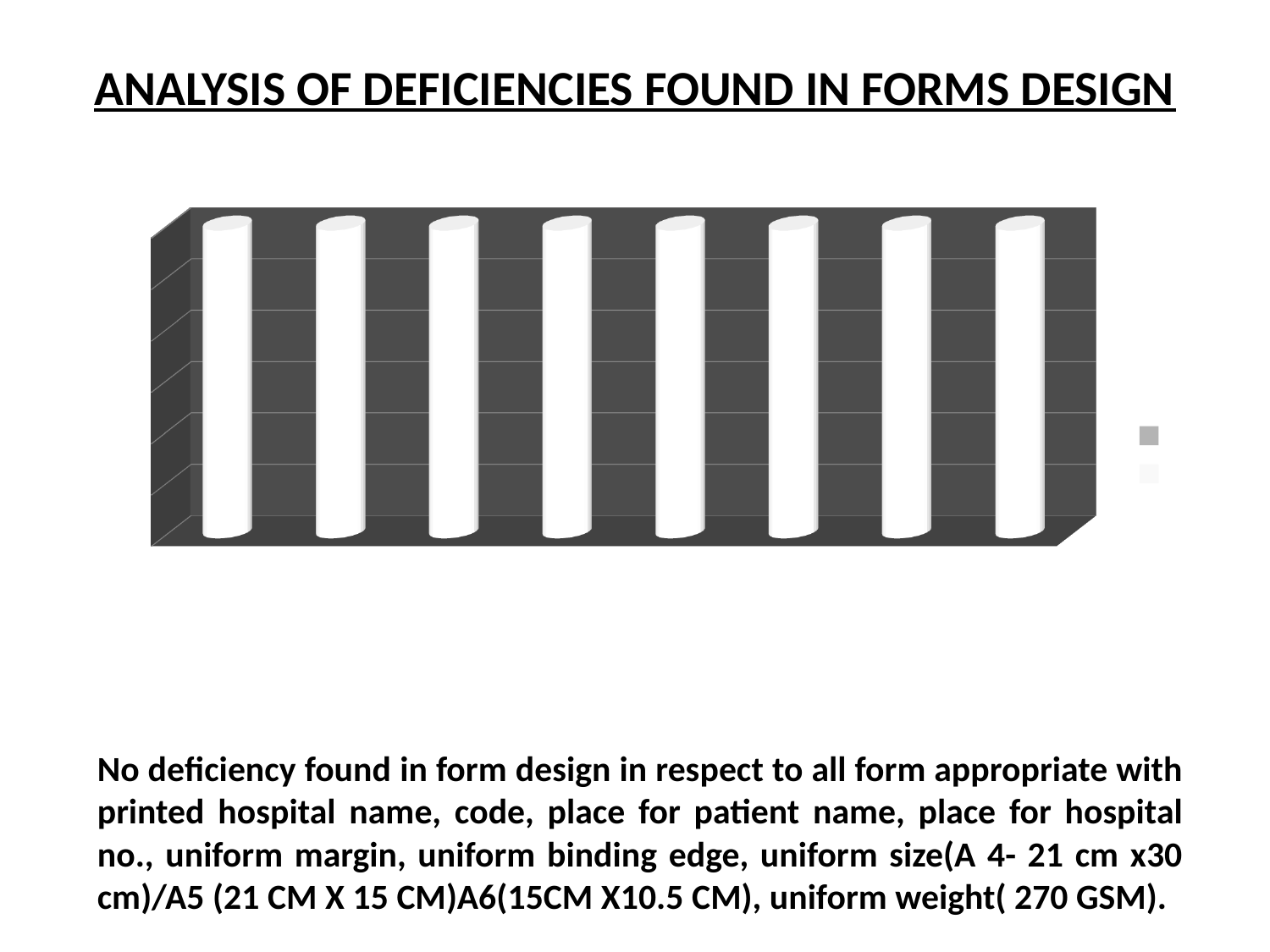
Do the bar heights rise, fall, or stay the same from left to right across the chart? stay the same How many bars are plotted in the chart? 8 What kind of chart is shown on the slide? bar chart What is the title of the slide containing the chart? ANALYSIS OF DEFICIENCIES FOUND IN FORMS DESIGN How many entries does the chart's legend list? 2 What colour are the bars in the chart? white